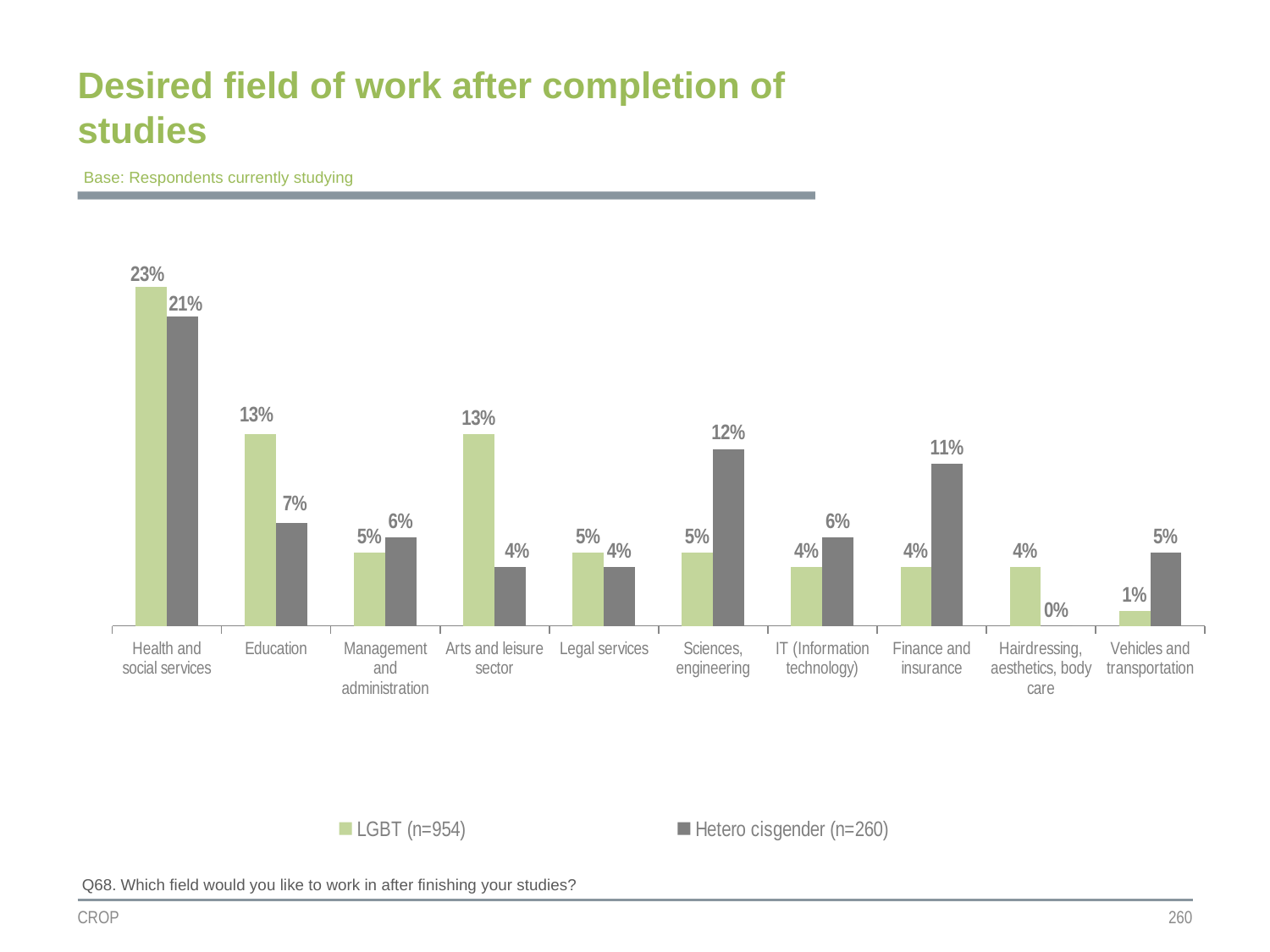
What kind of chart is shown on the slide? Bar chart What is the difference between the LGBT and Hetero cisgender values for Arts and leisure sector? 9% Which group has the larger value for Sciences, engineering, LGBT or Hetero cisgender? Hetero cisgender What is the value for LGBT respondents in Vehicles and transportation? 1% Which field has the highest value for Hetero cisgender respondents? Health and social services Which field has the lowest value for Hetero cisgender respondents? Hairdressing, aesthetics, body care How many fields of work are shown on the x axis? 10 What is the difference between the Hetero cisgender and LGBT values for Finance and insurance? 7% What is the value for Hetero cisgender respondents in Sciences, engineering? 12% How many series does the legend list? 2 What percentage of LGBT respondents want to work in Health and social services? 23% Which group has the larger value for Education, LGBT or Hetero cisgender? LGBT